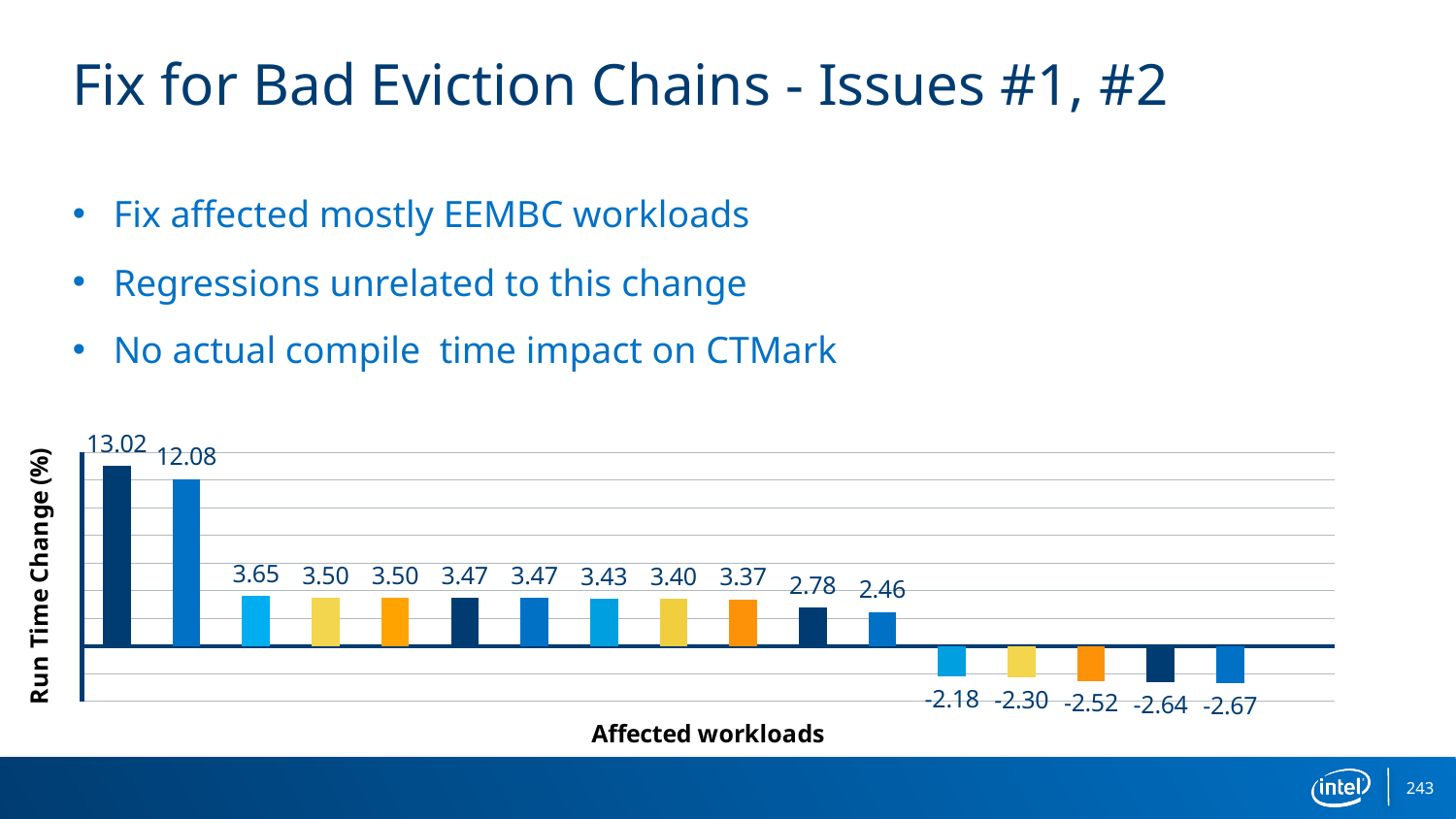
What is the difference between the two highest values in the chart (13.02 and 12.08)? 0.94 What kind of chart is shown on the slide? Bar chart Do the bar values rise or fall from left to right across the chart? Fall What is the lowest value shown in the chart? -2.67 How many bars are plotted in the chart? 17 What is the title of the horizontal axis of the chart? Affected workloads Which is larger, the value of the second bar from the left (12.08) or the third bar from the left (3.65)? 12.08 What is the title of the vertical axis of the chart? Run Time Change (%) What is the value of the rightmost bar in the chart? -2.67 What is the value of the leftmost bar in the chart? 13.02 What is the highest value shown in the chart? 13.02 How many bars in the chart have negative values? 5